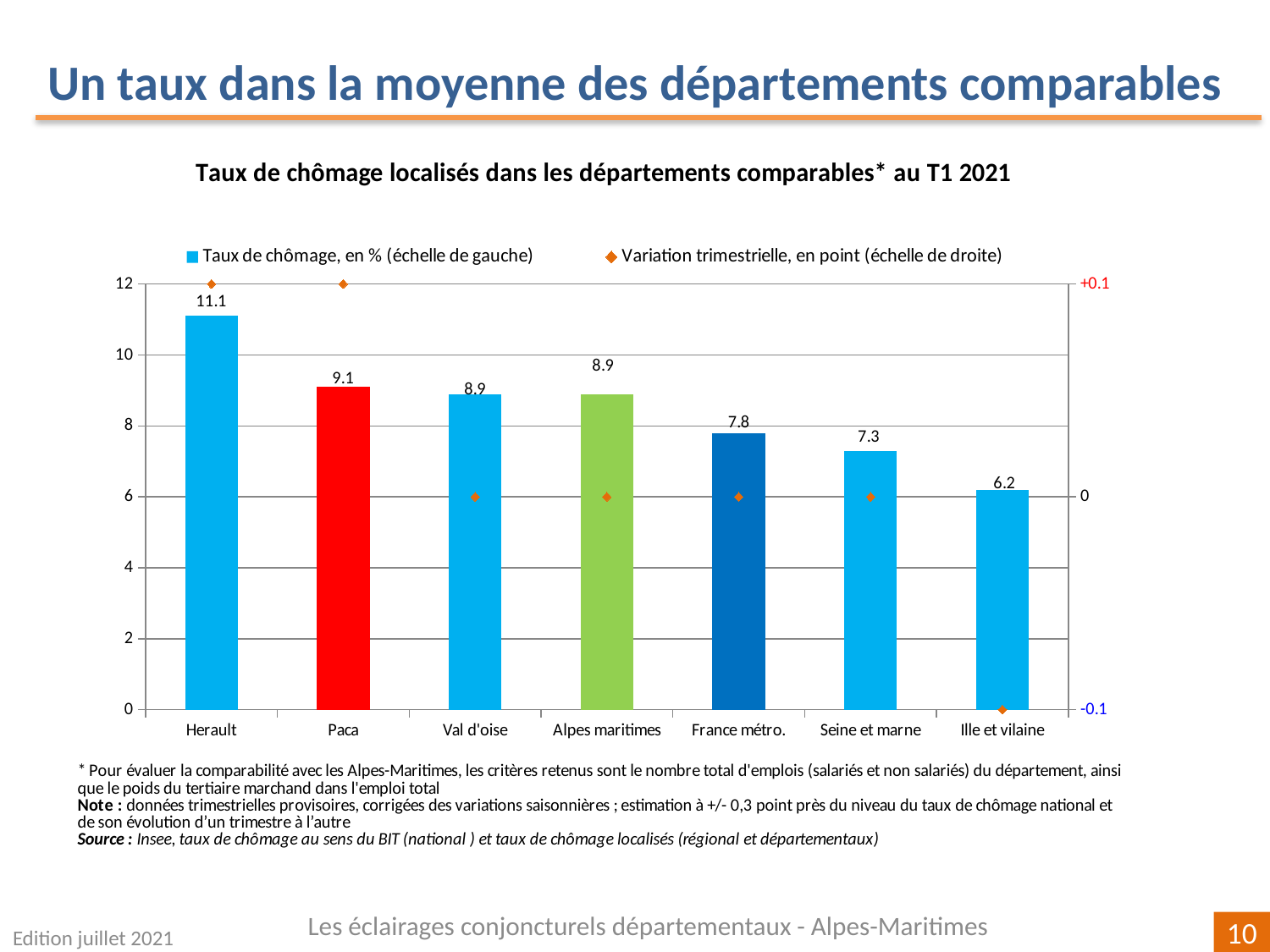
What is the quarterly variation (Variation trimestrielle) shown for Ille et vilaine on the right-hand scale? -0.1 What is the unemployment rate shown for France métro.? 7.8 Which has a higher unemployment rate, Paca or Seine et marne? Paca What is the difference between the unemployment rates of Herault and Ille et vilaine? 4.9 Do the unemployment rate bars rise or fall from left to right along the x axis? fall What is the quarterly variation shown for Herault on the right-hand scale? +0.1 How many series does the legend list? 2 How many categories are shown on the x axis? 7 Which category has the highest unemployment rate bar? Herault What is the unemployment rate shown for Alpes maritimes? 8.9 Which category has the lowest unemployment rate bar? Ille et vilaine What is the unemployment rate (Taux de chômage) shown for Herault? 11.1